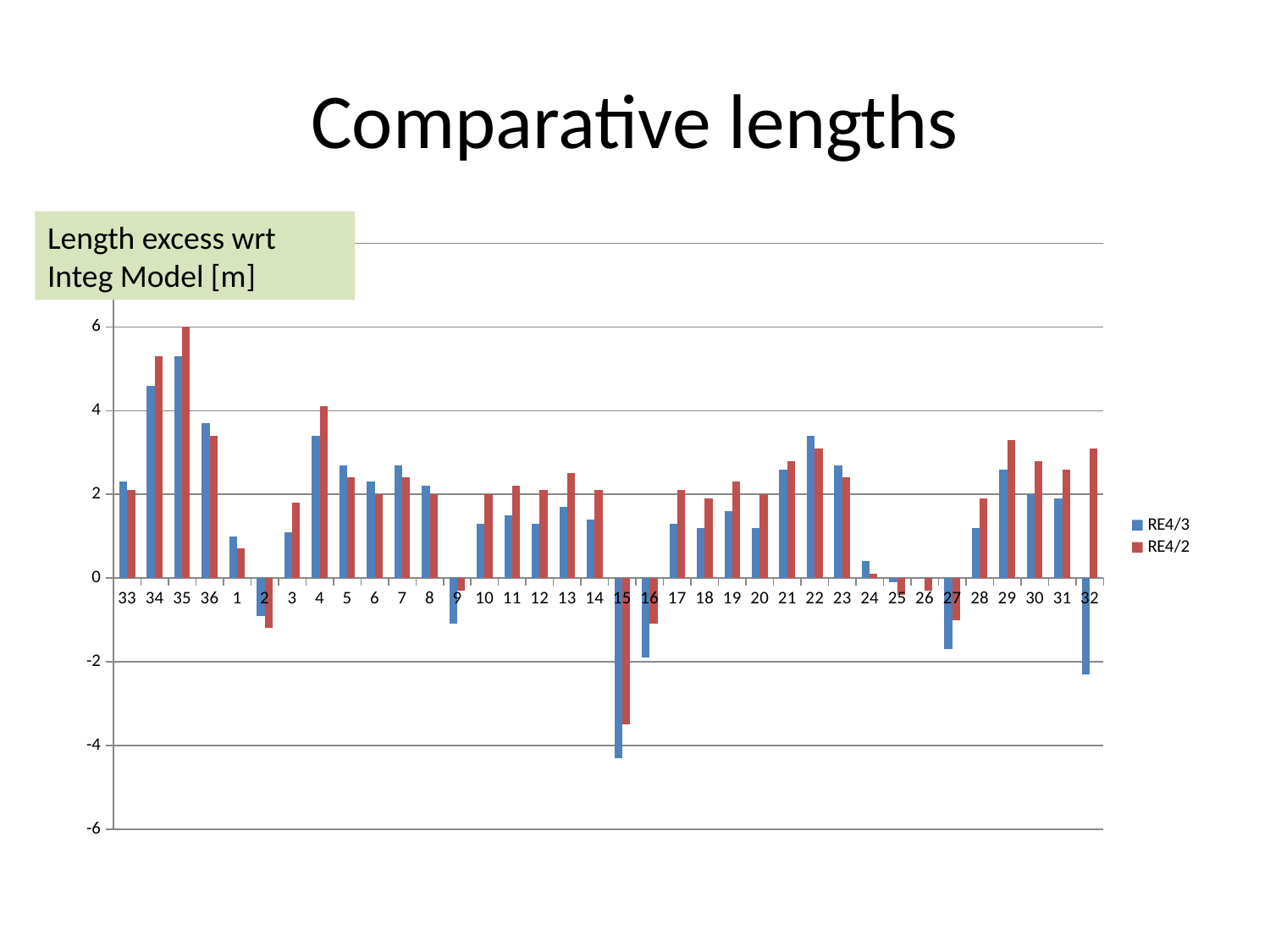
For category 32, which series has the larger value, RE4/3 or RE4/2? RE4/2 What is the label shown in the box at the top left of the chart? Length excess wrt Integ Model [m] How many series does the legend list? 2 Is the RE4/2 value for category 2 greater or less than 0? less For category 34, which series has the larger value, RE4/3 or RE4/2? RE4/2 How many categories are shown along the x axis? 36 Is the RE4/3 value for category 34 greater or less than 4? greater Which category has the highest RE4/2 value? 35 Which category has the lowest RE4/3 value? 15 Is the RE4/3 value for category 15 greater or less than -4? less What kind of chart is shown on the slide? bar chart